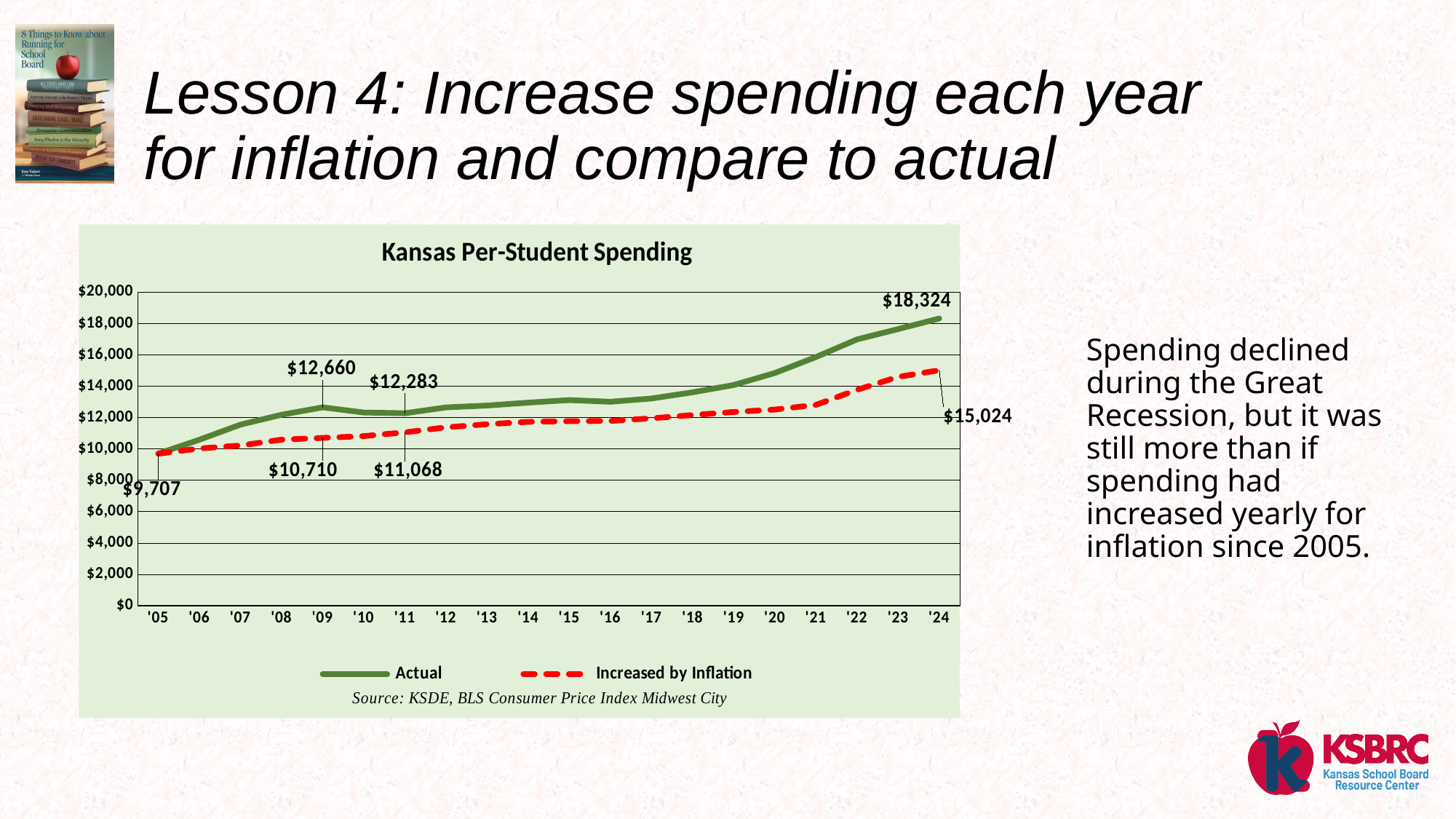
How many years are shown on the x axis? 20 What is the Actual value labeled for '09? $12,660 What is the difference between the Actual and Increased by Inflation values in '24? $3,300 What kind of chart is shown on the slide? line chart What is the Increased by Inflation value labeled for '11? $11,068 What is the title of the chart? Kansas Per-Student Spending In '11, which series has the larger value, Actual or Increased by Inflation? Actual How many series does the chart's legend list? 2 What is the difference between the Actual and Increased by Inflation values in '09? $1,950 What is the Increased by Inflation value labeled for '24? $15,024 Is the Actual value for '22 greater or less than $16,000? greater What is the Actual per-student spending value labeled for '24? $18,324